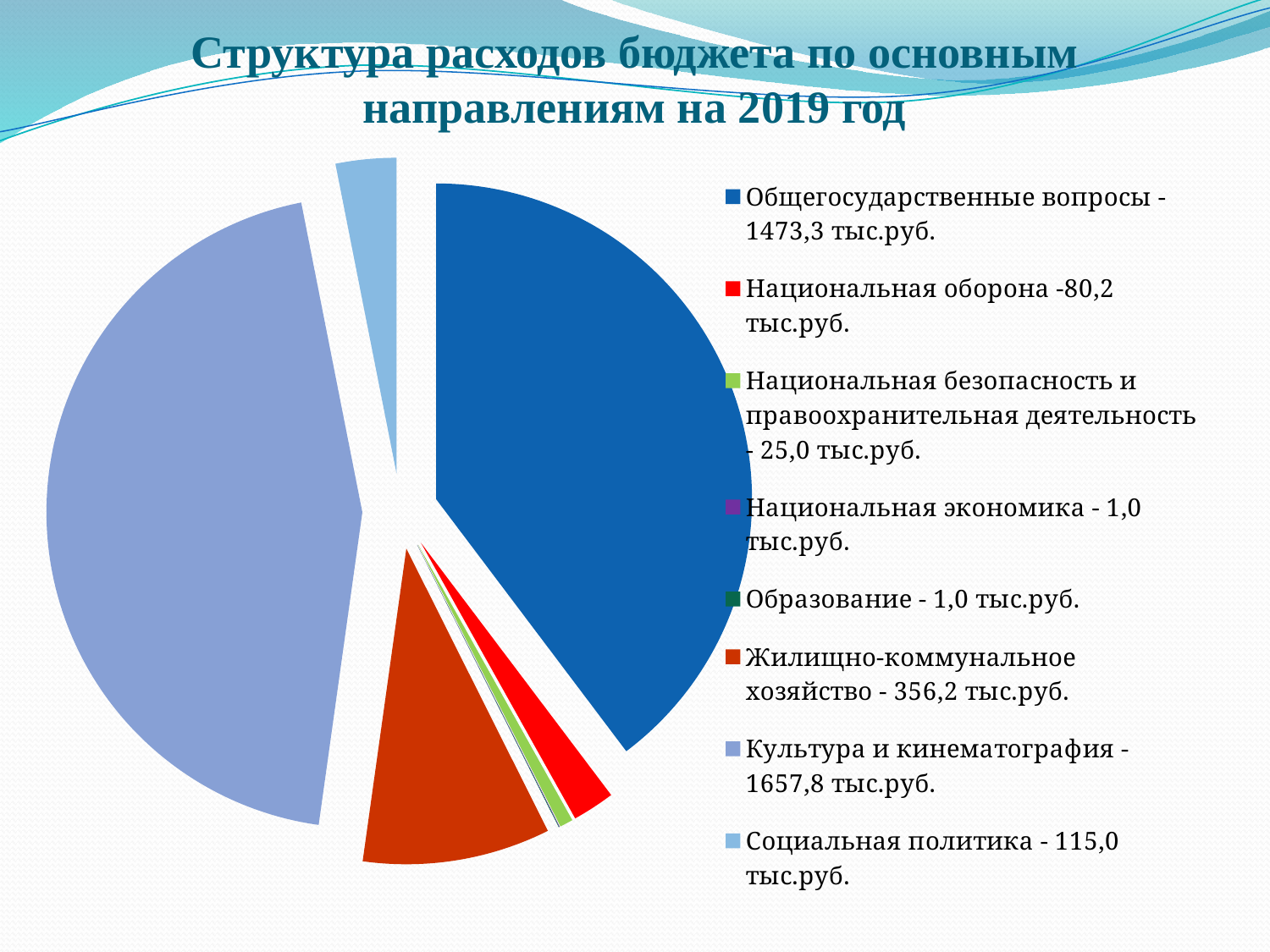
Which category has the largest share of the pie? Культура и кинематография What is the value for Образование? 1,0 тыс.руб. Which is larger: Общегосударственные вопросы or Жилищно-коммунальное хозяйство? Общегосударственные вопросы How many categories does the pie chart show? 8 What is the value for Культура и кинематография? 1657,8 тыс.руб. What is the difference between Культура и кинематография and Общегосударственные вопросы? 184,5 тыс.руб. What is the title of the chart on the slide? Структура расходов бюджета по основным направлениям на 2019 год What kind of chart is shown on the slide? pie chart What is the value for Национальная оборона? 80,2 тыс.руб. What is the value for Социальная политика? 115,0 тыс.руб. What is the value for Жилищно-коммунальное хозяйство? 356,2 тыс.руб. What is the difference between Жилищно-коммунальное хозяйство and Социальная политика? 241,2 тыс.руб.